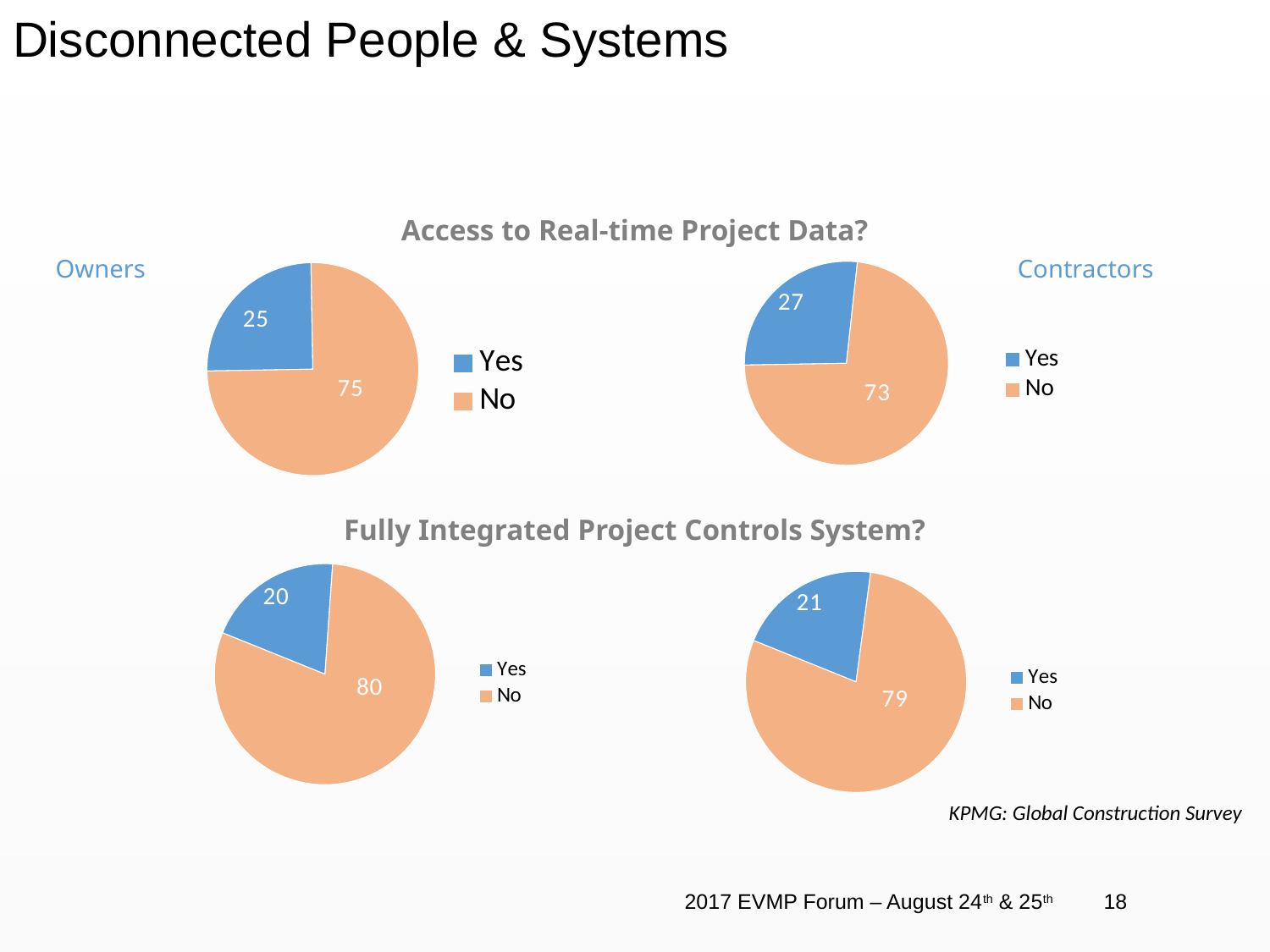
In the Contractors pie chart under "Access to Real-time Project Data?", what is the value for Yes? 27 In the bottom-left pie chart under "Fully Integrated Project Controls System?", which slice is the smallest? Yes In the Contractors pie chart under "Access to Real-time Project Data?", what is the value for No? 73 In the bottom-right pie chart under "Fully Integrated Project Controls System?", what is the value for No? 79 In the Owners pie chart under "Access to Real-time Project Data?", what is the difference between the No and Yes values? 50 In the Owners pie chart under "Access to Real-time Project Data?", what is the value for Yes? 25 In the Contractors pie chart under "Access to Real-time Project Data?", which slice is the largest? No How many entries does the legend list for the bottom-right pie chart under "Fully Integrated Project Controls System?"? 2 Which is larger: the Yes value in the Owners pie chart or the Yes value in the Contractors pie chart under "Access to Real-time Project Data?"? Contractors In the Owners pie chart under "Access to Real-time Project Data?", what is the value for No? 75 In the bottom-left pie chart under "Fully Integrated Project Controls System?", what is the value for Yes? 20 What kind of chart is used for the Owners chart under "Access to Real-time Project Data?"? Pie chart